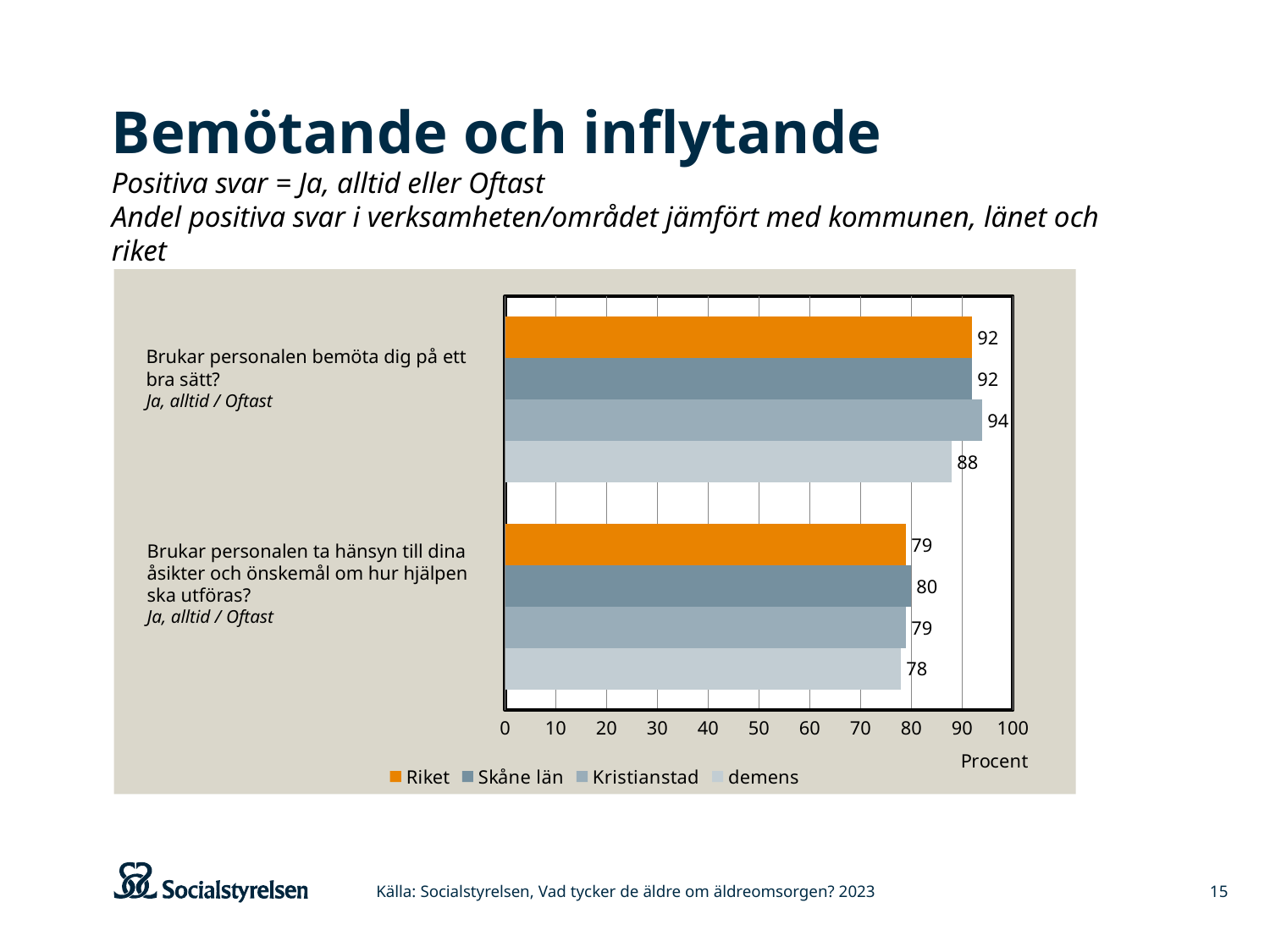
What is the value for Kristianstad on the question "Brukar personalen bemöta dig på ett bra sätt?"? 94 How many question categories are shown on the chart? 2 What is the value for demens on the question "Brukar personalen bemöta dig på ett bra sätt?"? 88 Which series has the highest value on the question "Brukar personalen bemöta dig på ett bra sätt?"? Kristianstad What is the difference between the Kristianstad and demens values on the question "Brukar personalen bemöta dig på ett bra sätt?"? 6 What kind of chart is shown on the slide? bar chart What is the value for Skåne län on the question "Brukar personalen ta hänsyn till dina åsikter och önskemål om hur hjälpen ska utföras?"? 80 Which is larger on the question "Brukar personalen ta hänsyn till dina åsikter och önskemål om hur hjälpen ska utföras?": Skåne län or demens? Skåne län What is the value for Riket on the question "Brukar personalen ta hänsyn till dina åsikter och önskemål om hur hjälpen ska utföras?"? 79 How many series does the legend list? 4 What unit is shown on the x axis of the chart? Procent Which series has the lowest value on the question "Brukar personalen ta hänsyn till dina åsikter och önskemål om hur hjälpen ska utföras?"? demens